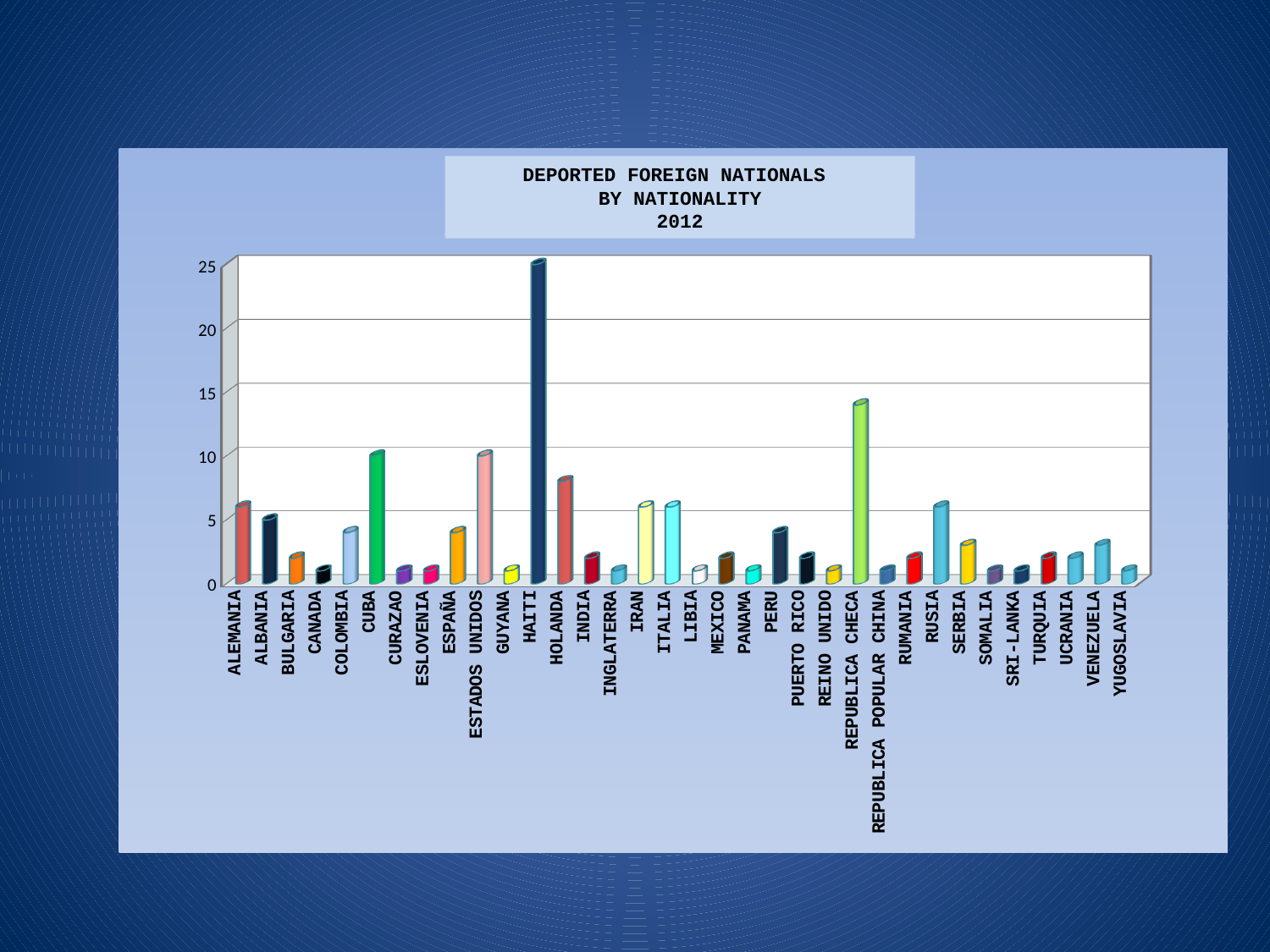
Which is larger, the value for HAITI or the value for REPUBLICA CHECA? HAITI Which is larger, the value for REPUBLICA CHECA or the value for CUBA? REPUBLICA CHECA Which nationality has the highest number of deported foreign nationals? HAITI Which is larger, the value for HOLANDA or the value for INDIA? HOLANDA Is the value for HAITI greater or less than 20? greater What is the title of the chart? DEPORTED FOREIGN NATIONALS BY NATIONALITY 2012 Is the value for REPUBLICA CHECA greater or less than 15? less How many nationalities are shown on the x axis? 34 Is the value for COLOMBIA greater or less than 5? less What kind of chart is shown on the slide? bar chart